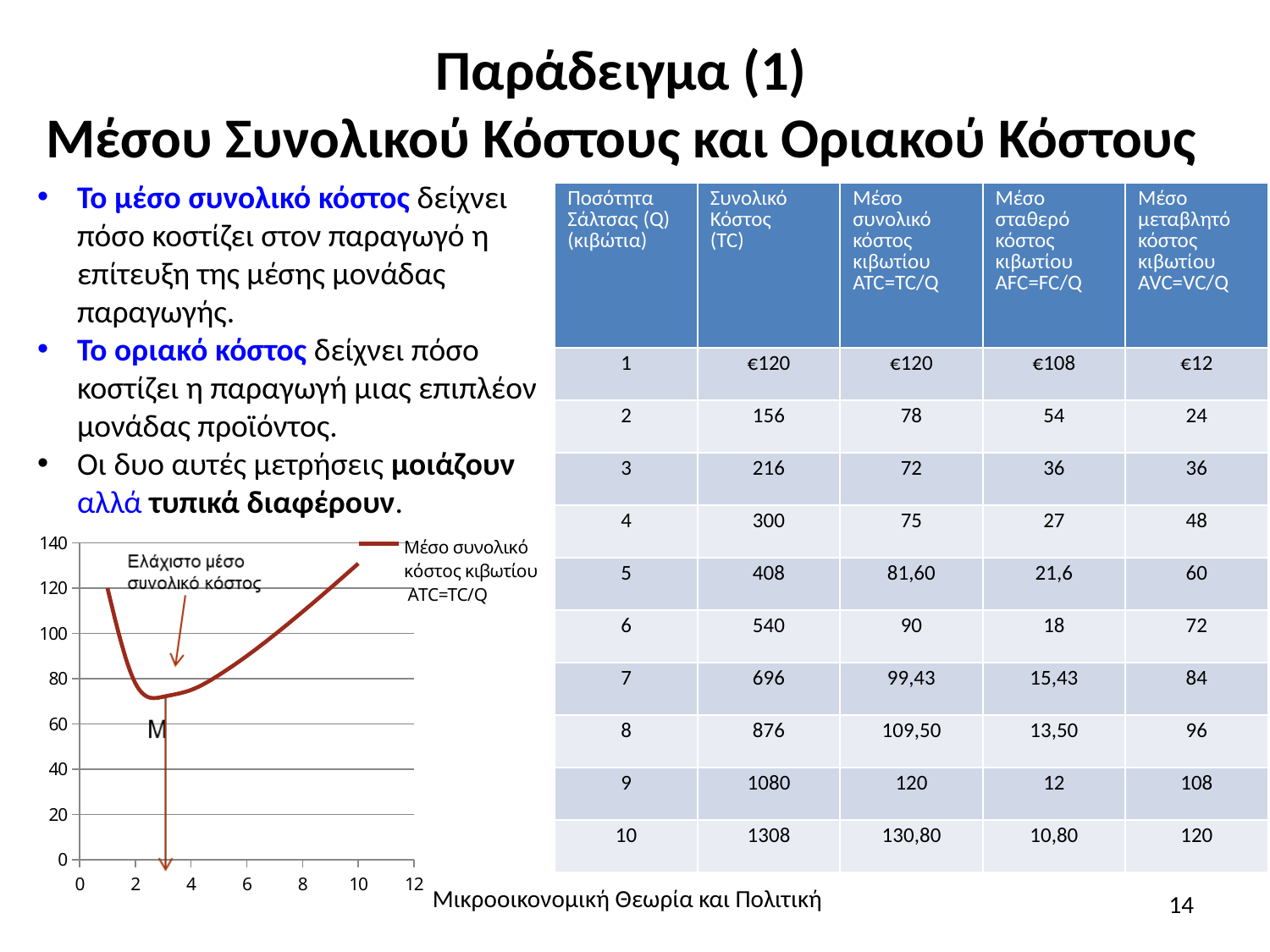
Is the value of the curve at x = 8 greater or less than 100? greater What annotation text points to the lowest point of the curve in the chart? Ελάχιστο μέσο συνολικό κόστος Is the value of the curve at x = 6 greater or less than 80? greater How many series does the chart's legend list? 1 Is the value of the curve at x = 10 greater or less than 120? greater What kind of chart is shown on the slide? line chart What is the highest value shown on the chart's vertical axis? 140 How does the curve behave as x increases from 1 to 10? falls first, then rises What series name does the chart's legend show? Μέσο συνολικό κόστος κιβωτίου ATC=TC/Q Does the curve rise or fall between x = 4 and x = 10? rises